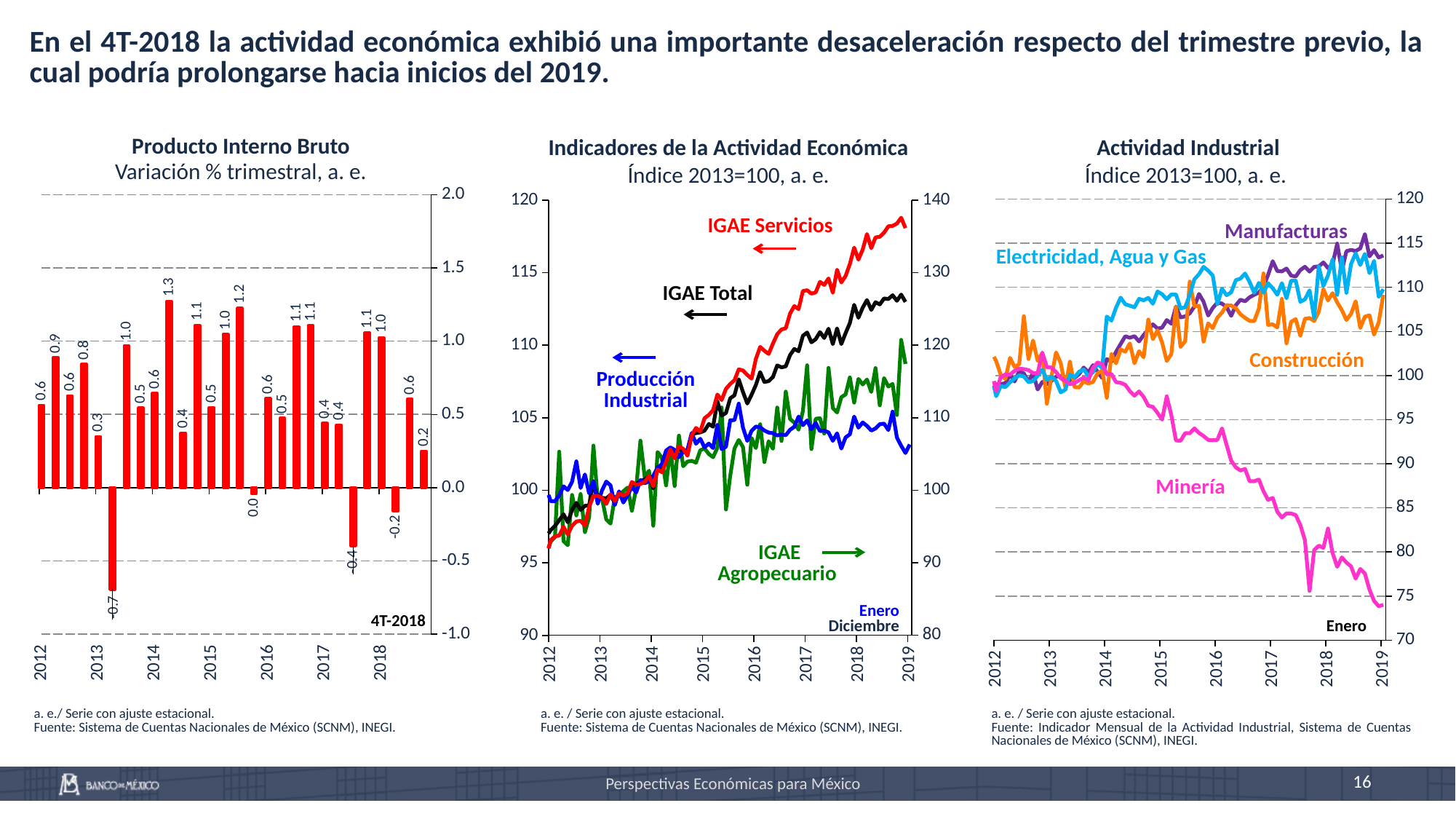
In the Producto Interno Bruto chart, what is the difference between the highest bar (1.3) and the lowest bar (-0.7)? 2.0 In the Indicadores de la Actividad Económica chart, what colour is the IGAE Servicios line? Red In the Producto Interno Bruto chart, what is the highest quarterly variation shown? 1.3 In the Producto Interno Bruto chart, how many bars are plotted? 28 What kind of chart is the Producto Interno Bruto chart? Bar chart In the Actividad Industrial chart, how many series are plotted? 4 In the Producto Interno Bruto chart, what is the value for 4T-2018? 0.2 In the Producto Interno Bruto chart, what is the lowest quarterly variation shown? -0.7 In the Actividad Industrial chart, is the value for Minería at the start of 2018 greater or less than 85? less In the Actividad Industrial chart, which series is higher at the start of 2019, Manufacturas or Minería? Manufacturas In the Actividad Industrial chart, does the Minería series rise or fall from 2012 to 2019? Fall In the Indicadores de la Actividad Económica chart, how many series are plotted? 4